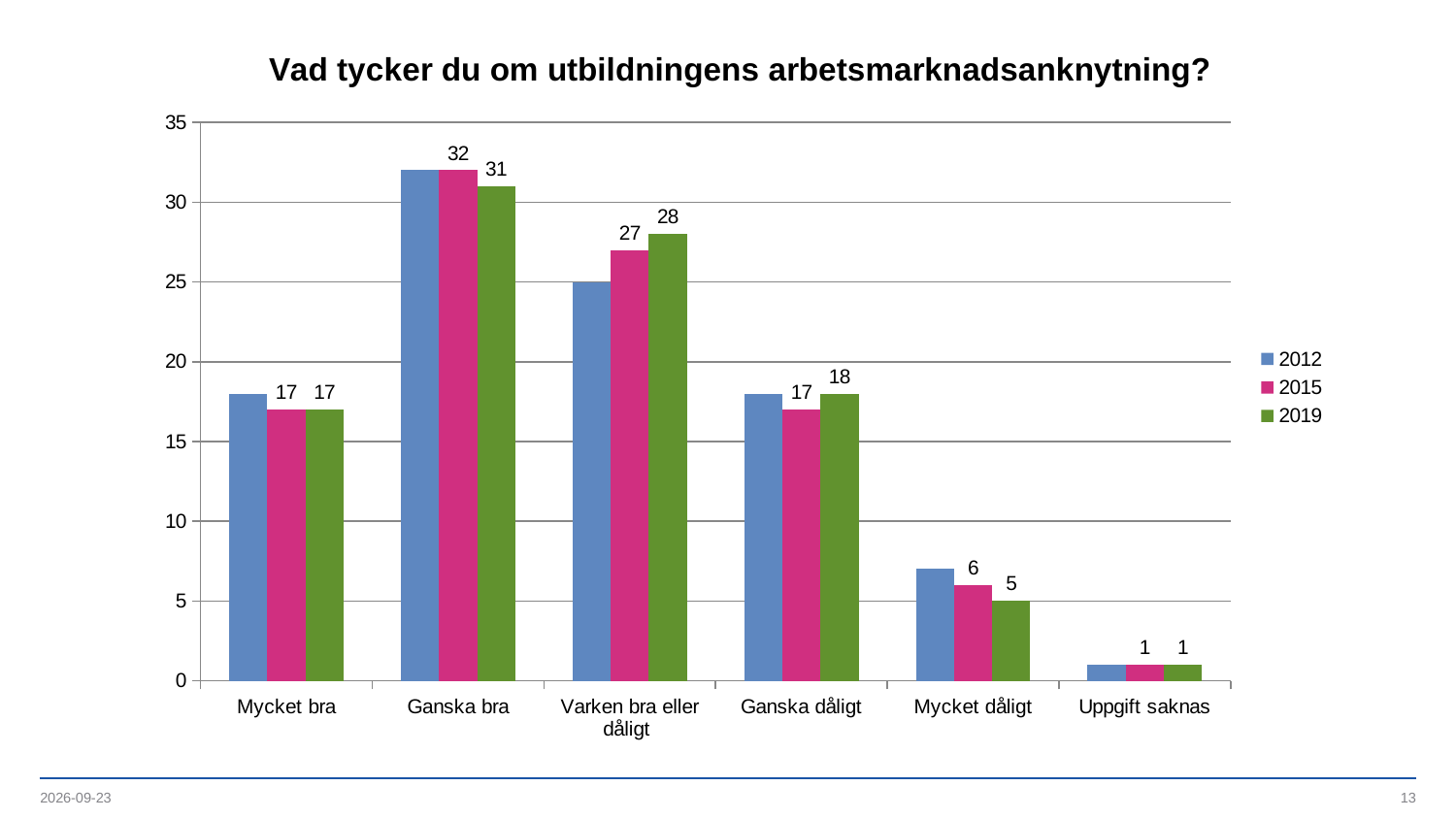
Which category has the highest value for the 2019 series? Ganska bra What is the value for 2019 in the Mycket dåligt category? 5 What kind of chart is shown on the slide? Bar chart What is the value for 2019 in the Varken bra eller dåligt category? 28 How many series does the legend list? 3 What is the difference between the 2019 and 2015 values in the Varken bra eller dåligt category? 1 How many categories are shown on the x axis? 6 Which category has the lowest value for the 2015 series? Uppgift saknas What is the title of the chart? Vad tycker du om utbildningens arbetsmarknadsanknytning? Is the value for 2012 in the Ganska bra category greater or less than 30? greater In the Ganska bra category, which is larger: the 2015 value or the 2019 value? 2015 What is the value for 2015 in the Ganska bra category? 32